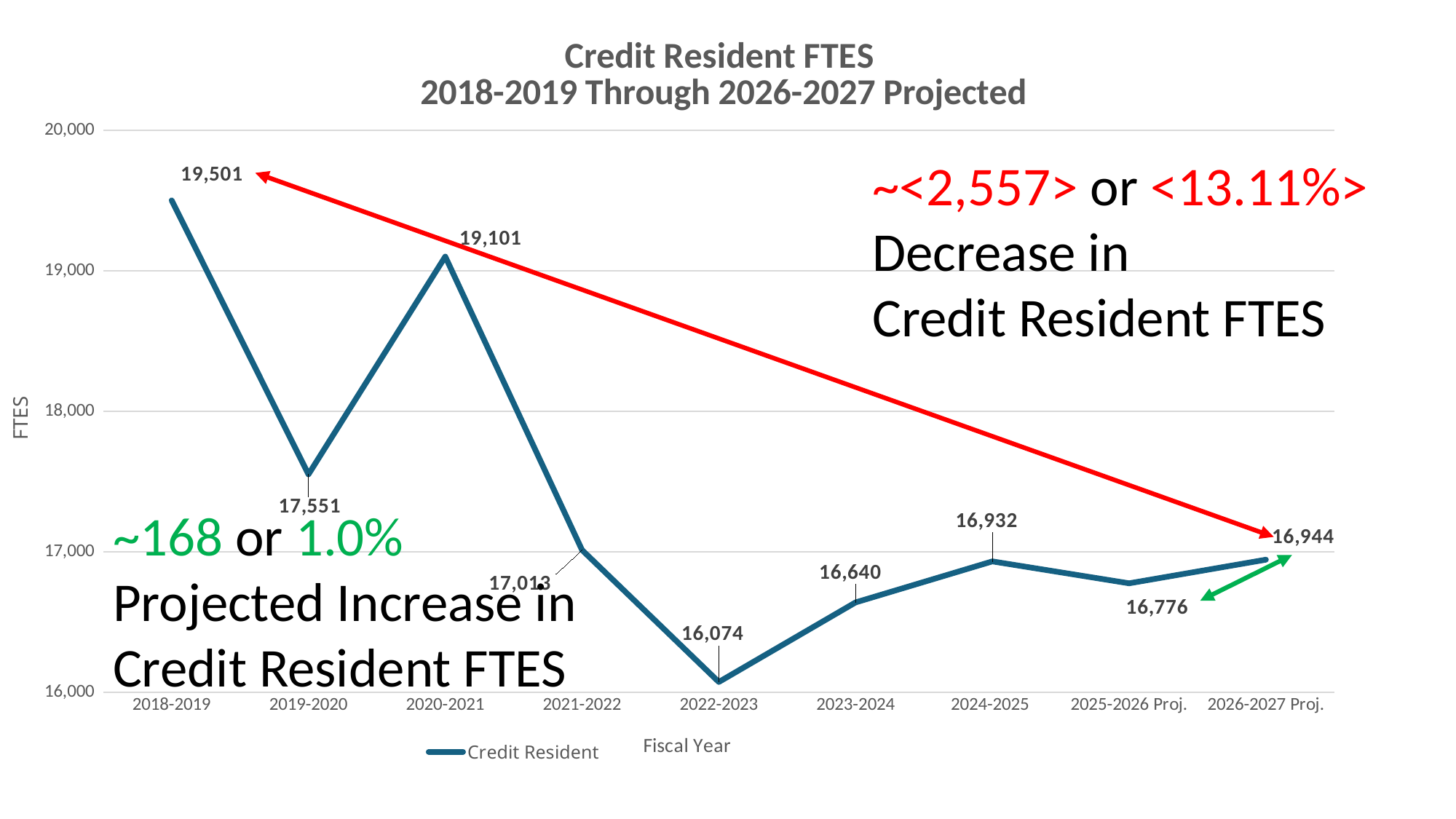
What kind of chart is shown on the slide? line chart What is the Credit Resident FTES value for 2018-2019? 19,501 What is the projected Credit Resident FTES value for 2026-2027? 16,944 What is the difference in Credit Resident FTES between 2018-2019 and 2019-2020? 1,950 How many fiscal years are plotted on the chart? 9 How many series does the legend list? 1 What is the Credit Resident FTES value for 2022-2023? 16,074 Which fiscal year has the lowest Credit Resident FTES? 2022-2023 Is the Credit Resident FTES value for 2021-2022 greater or less than 18,000? less Which fiscal year has the highest Credit Resident FTES? 2018-2019 Which is larger, the Credit Resident FTES for 2024-2025 or for 2025-2026 Proj.? 2024-2025 What is the label on the vertical axis of the chart? FTES